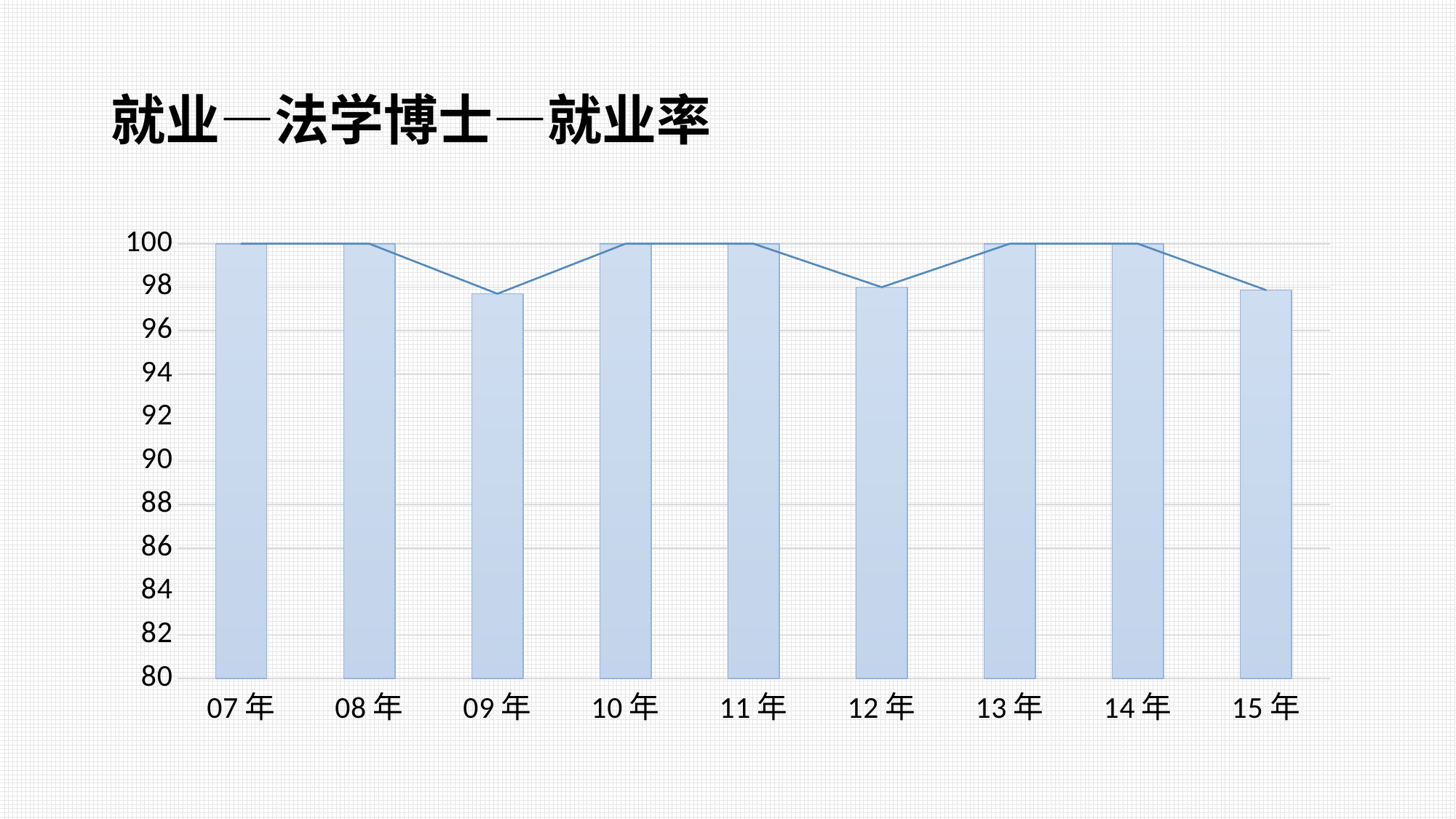
Is the value for 09 年 greater or less than 98? less Is the value for 12 年 greater or less than 96? greater Is the value for 09 年 greater or less than 96? greater What is the value for 13 年? 100 Which is larger, the value for 12 年 or the value for 13 年? 13 年 What is the value for 10 年? 100 What is the title of the slide? 就业—法学博士—就业率 Which is larger, the value for 08 年 or the value for 09 年? 08 年 How many years have a value of 100? 6 What is the value for 07 年? 100 How many years are shown on the x axis of the chart? 9 What kind of chart is shown on the slide? bar and line chart